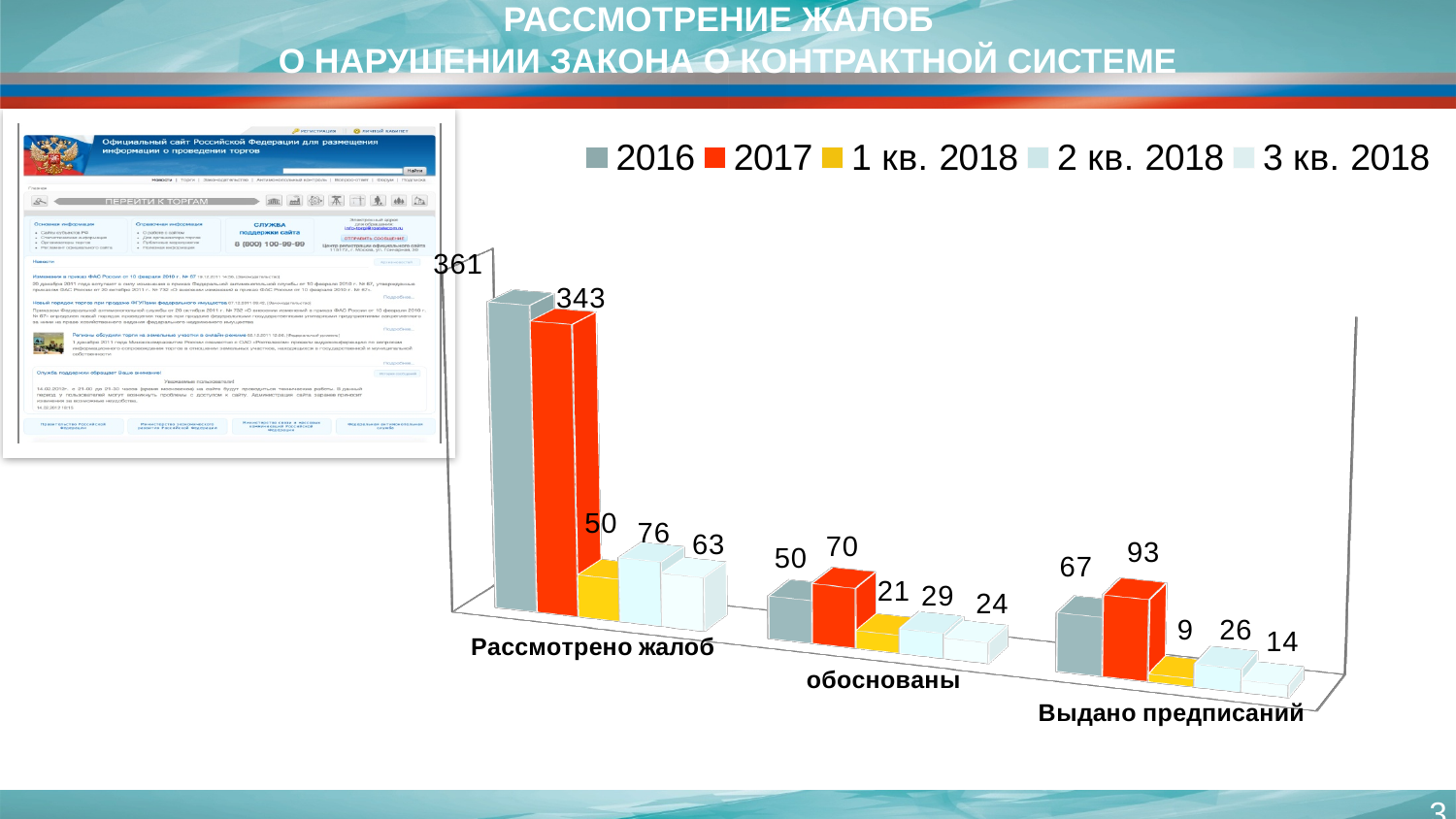
How many categories are shown on the x axis of the chart? 3 Which series has the lowest value in the category "обоснованы"? 1 кв. 2018 Which series has the highest value in the category "Выдано предписаний"? 2017 What is the value for 2016 in the category "Рассмотрено жалоб"? 361 Which is larger in the category "Выдано предписаний": the value for 2 кв. 2018 or the value for 3 кв. 2018? 2 кв. 2018 What type of chart is shown on the slide? bar chart What is the value for 1 кв. 2018 in the category "Выдано предписаний"? 9 What is the value for 2 кв. 2018 in the category "Рассмотрено жалоб"? 76 How many series does the legend list? 5 What is the value for 2017 in the category "обоснованы"? 70 What is the difference between the 2016 and 2017 values in the category "Рассмотрено жалоб"? 18 What colour represents the 2017 series in the chart? red